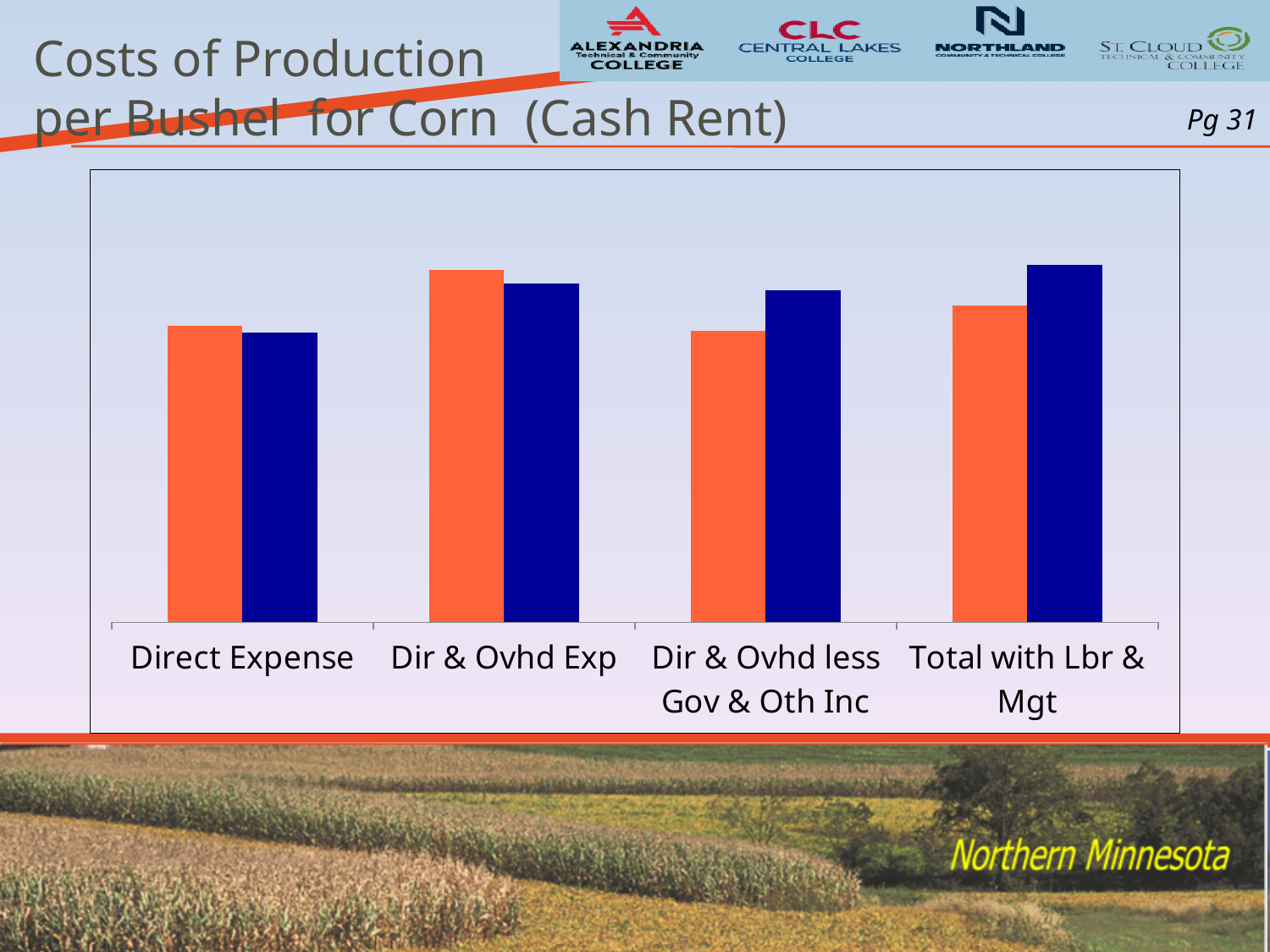
Which category has the shortest blue bar? Direct Expense Which category has the tallest blue bar? Total with Lbr & Mgt For Dir & Ovhd Exp, is the orange bar or the blue bar taller? orange What is the label of the third category on the x axis? Dir & Ovhd less Gov & Oth Inc Is the blue bar for Total with Lbr & Mgt taller or shorter than the blue bar for Dir & Ovhd Exp? taller Which category has the tallest orange bar? Dir & Ovhd Exp For Dir & Ovhd less Gov & Oth Inc, is the orange bar or the blue bar taller? blue How many categories are shown along the x axis of the chart? 4 What is the title of the slide containing the chart? Costs of Production per Bushel for Corn (Cash Rent) What kind of chart is shown on the slide? bar chart How many bars are plotted for each category in the chart? 2